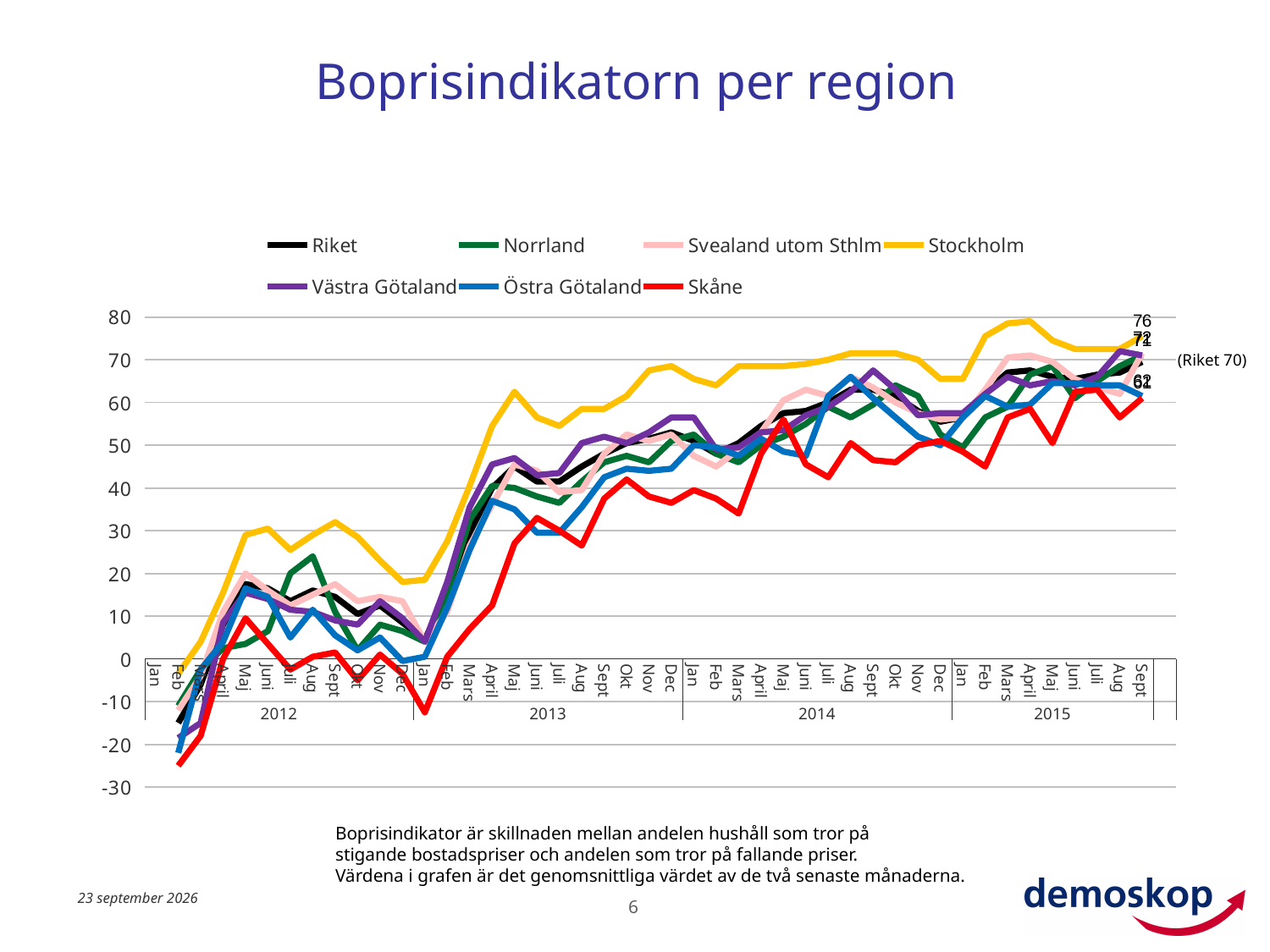
Is the value for Stockholm in April 2015 greater or less than 70? greater How many years are labelled on the x axis? 4 What is the value for Stockholm at the last point (Sept 2015)? 76 What is the title of the chart? Boprisindikatorn per region Which is larger at Sept 2015, Stockholm or Skåne? Stockholm Do the values generally rise or fall from 2012 to 2015? rise What is the value for Riket at the last point (Sept 2015)? 70 Is the value for Skåne in Feb 2012 greater or less than -20? less How many series does the legend list? 7 Which series has the highest value at the last point (Sept 2015)? Stockholm What kind of chart is shown on the slide? line chart What is the difference between Stockholm and Riket at the last point (Sept 2015)? 6